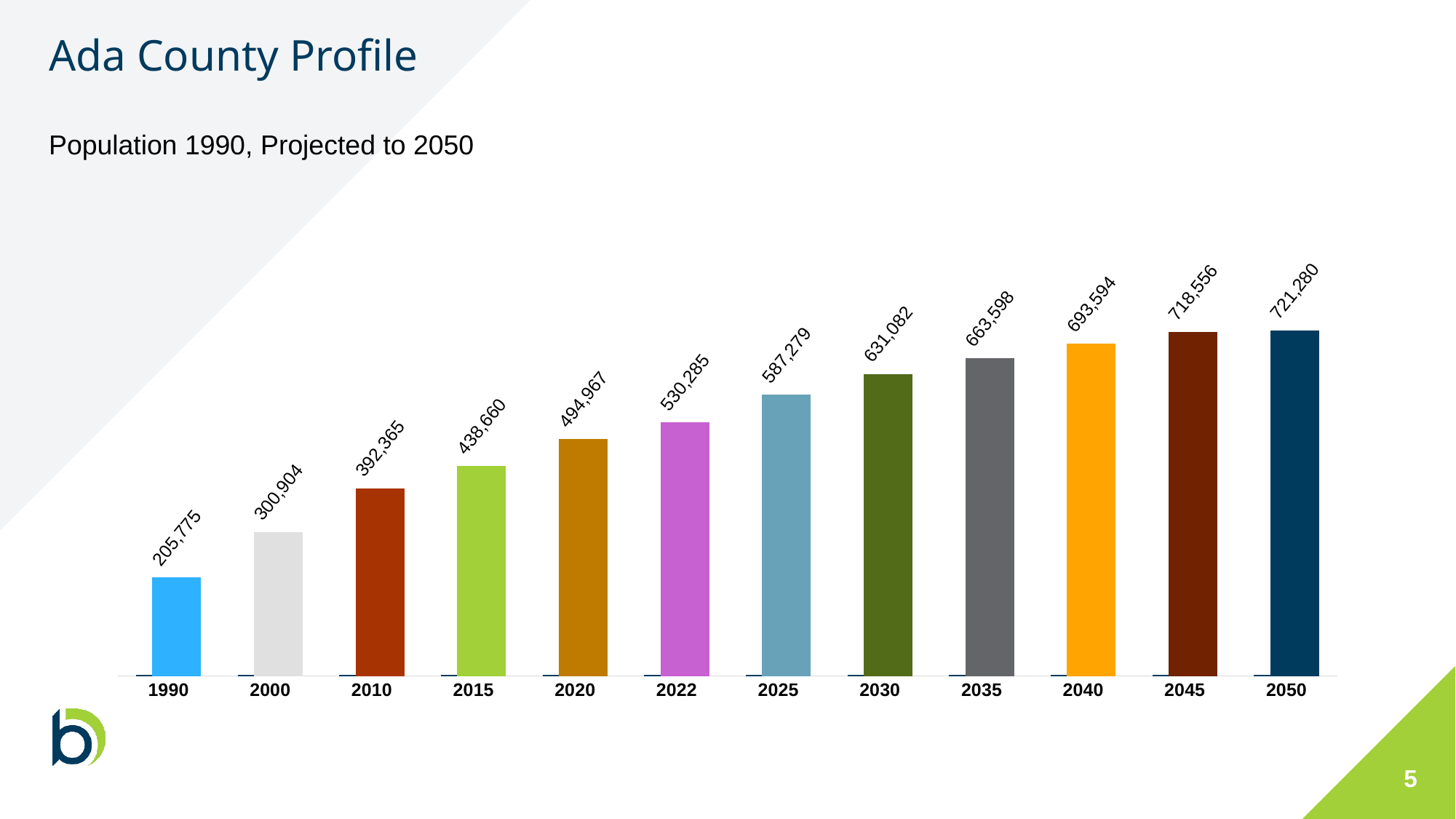
What is the difference between the population values for 2050 and 1990? 515,505 What is the difference between the population values for 2000 and 1990? 95,129 What is the population value shown for 1990? 205,775 What is the projected population shown for 2040? 693,594 What is the population value shown for 2022? 530,285 Do the population values rise or fall from 1990 to 2050? Rise Which is larger, the population value for 2025 or for 2020? 2025 Which year has the lowest population value on the chart? 1990 Which year has the highest population value on the chart? 2050 What kind of chart is shown on the slide? Bar chart What is the subtitle describing the chart on the slide? Population 1990, Projected to 2050 How many years (bars) are shown on the chart? 12